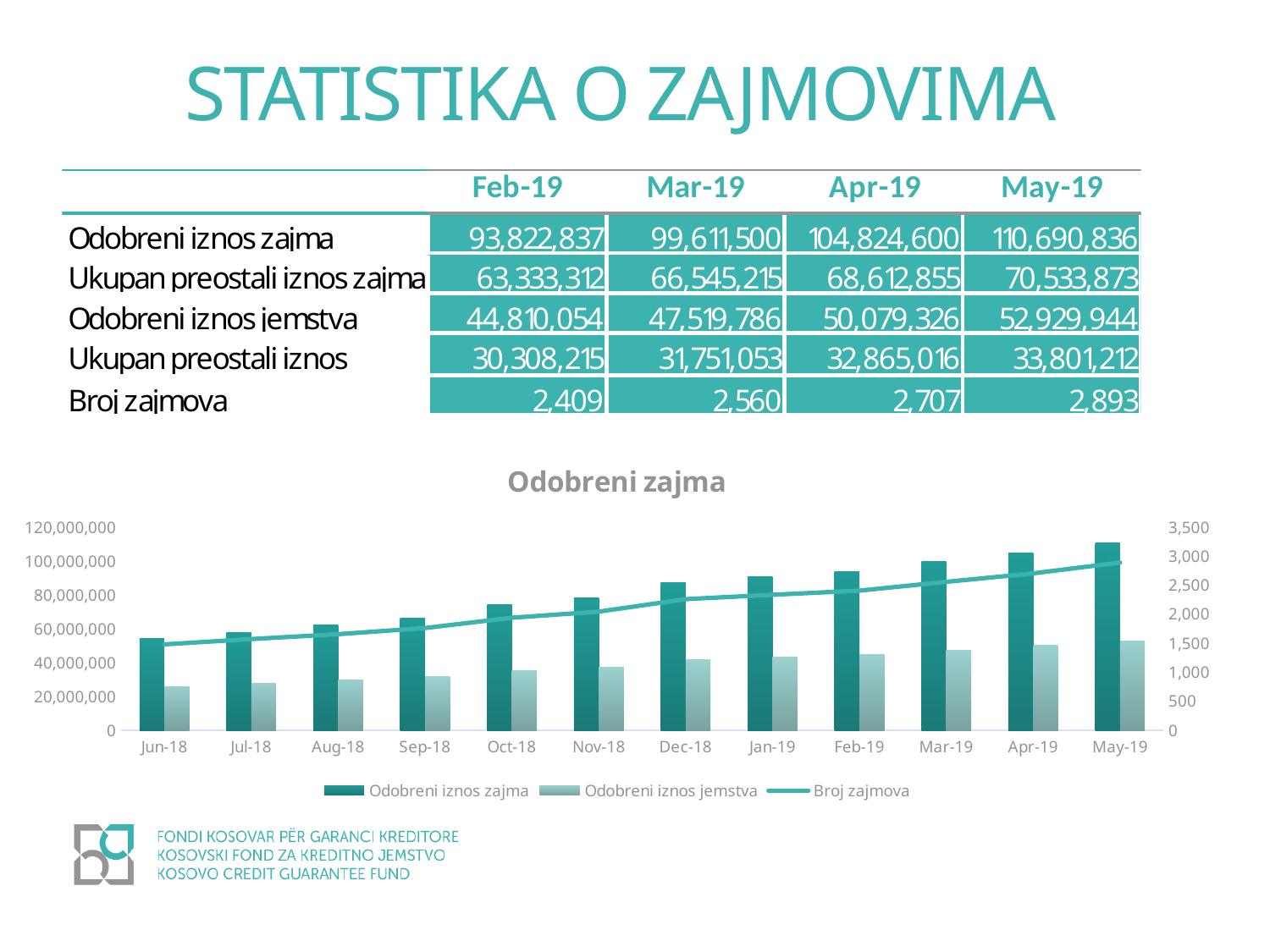
Is the value for Odobreni iznos zajma in Jun-18 greater or less than 40,000,000? greater Is the value for Odobreni iznos zajma in Dec-18 greater or less than 80,000,000? greater Which month has the lowest value for Odobreni iznos jemstva in the chart? Jun-18 What is the value for Broj zajmova in Feb-19? 2,409 Is the value for Broj zajmova in Dec-18 greater or less than 2,000? greater How many series does the chart legend list? 3 Do the values for Odobreni iznos zajma rise or fall from Jun-18 to May-19? Rise What is the value for Odobreni iznos zajma in May-19? 110,690,836 What kind of chart is shown on the slide? Bar chart with a line Which month has the highest value for Odobreni iznos zajma in the chart? May-19 What is the title of the chart? Odobreni zajma How many months are shown along the x axis of the chart? 12